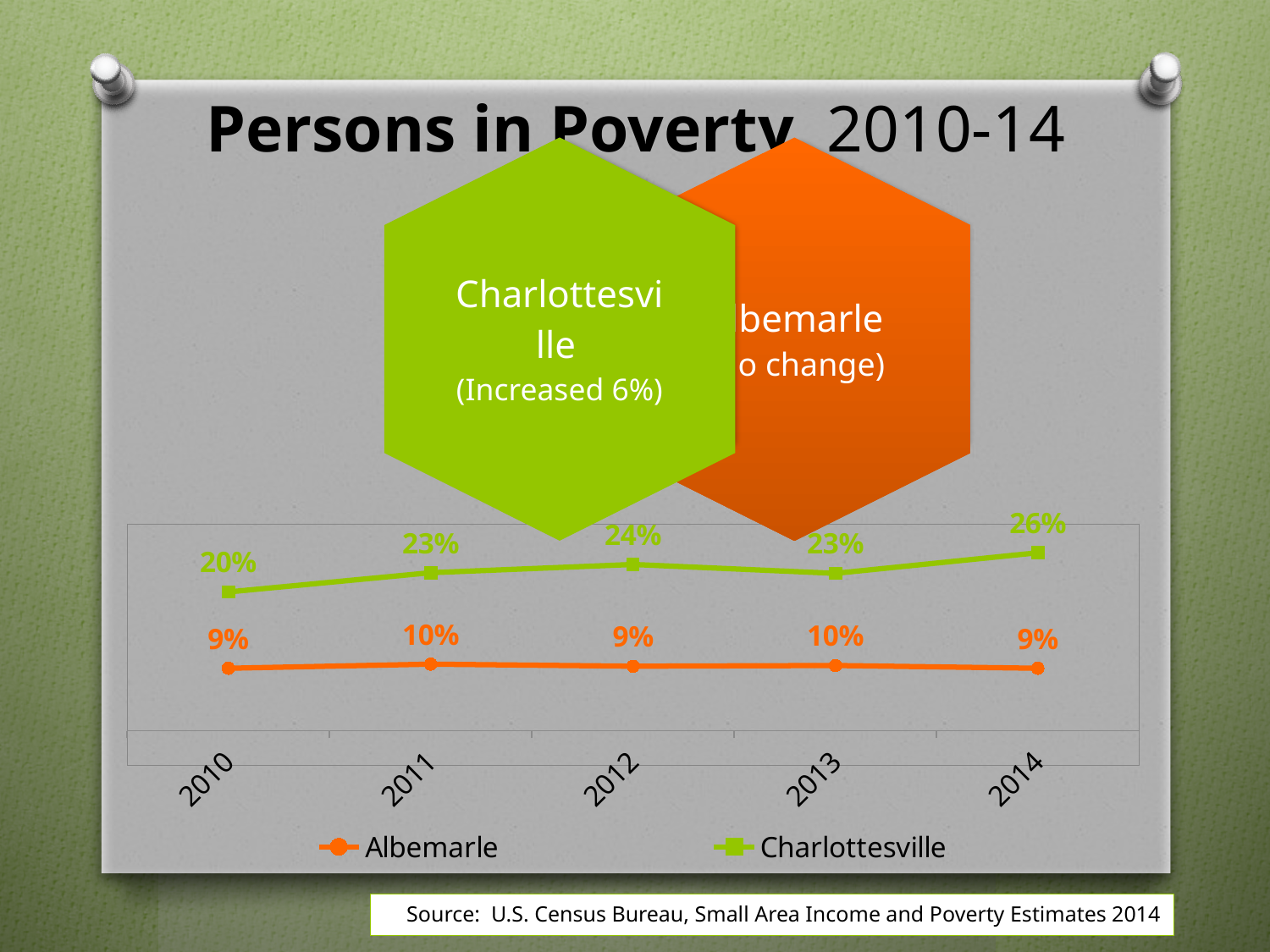
What was the Albemarle poverty rate in 2011? 10% Which series had the higher poverty rate in 2012, Albemarle or Charlottesville? Charlottesville What was the Charlottesville poverty rate in 2014? 26% In which year was the Charlottesville poverty rate lowest? 2010 In which year was the Charlottesville poverty rate highest? 2014 What kind of chart is shown on the slide? line chart Does the Charlottesville poverty rate rise or fall from 2010 to 2014? rise What was the Albemarle poverty rate in 2013? 10% What was the Charlottesville poverty rate in 2010? 20% What is the difference between the Charlottesville and Albemarle poverty rates in 2014? 17% How many series does the legend list? 2 How many years are shown on the x axis? 5